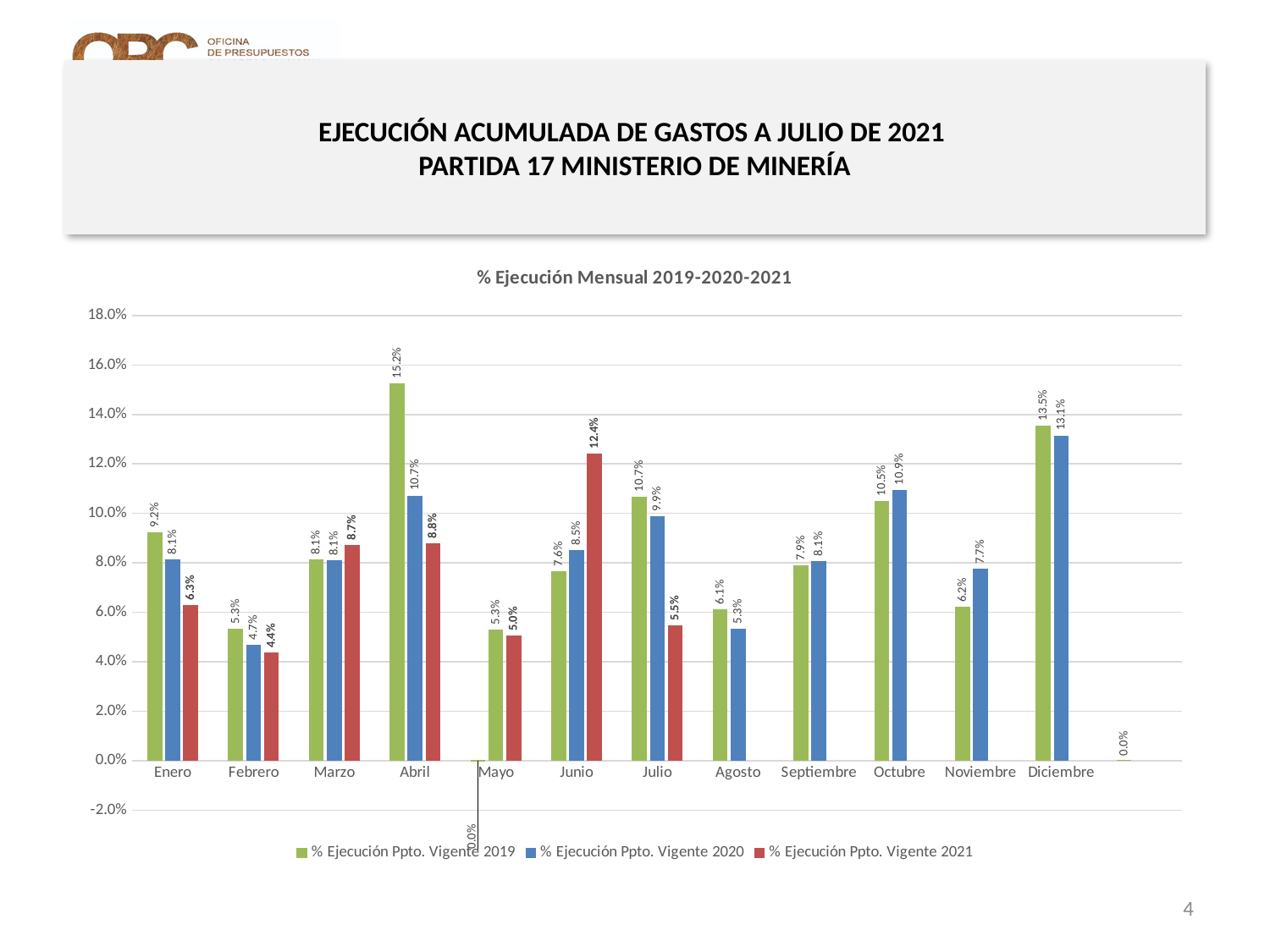
For Octubre, which series has the larger value, 2019 or 2020? % Ejecución Ppto. Vigente 2020 What is the difference between the 2019 and 2020 values for Abril? 4.5 percentage points How many series does the legend list? 3 What is the value for Junio in the % Ejecución Ppto. Vigente 2021 series? 12.4% What kind of chart is shown on the slide? Bar chart How many months are labelled on the x axis? 12 Which month has the lowest value in the % Ejecución Ppto. Vigente 2021 series? Febrero Which month has the highest value in the % Ejecución Ppto. Vigente 2019 series? Abril Which month has the highest value in the % Ejecución Ppto. Vigente 2021 series? Junio What is the value for Noviembre in the % Ejecución Ppto. Vigente 2020 series? 7.7% Is the value for Diciembre in the 2019 series greater or less than 12.0%? greater What is the value for Abril in the % Ejecución Ppto. Vigente 2019 series? 15.2%